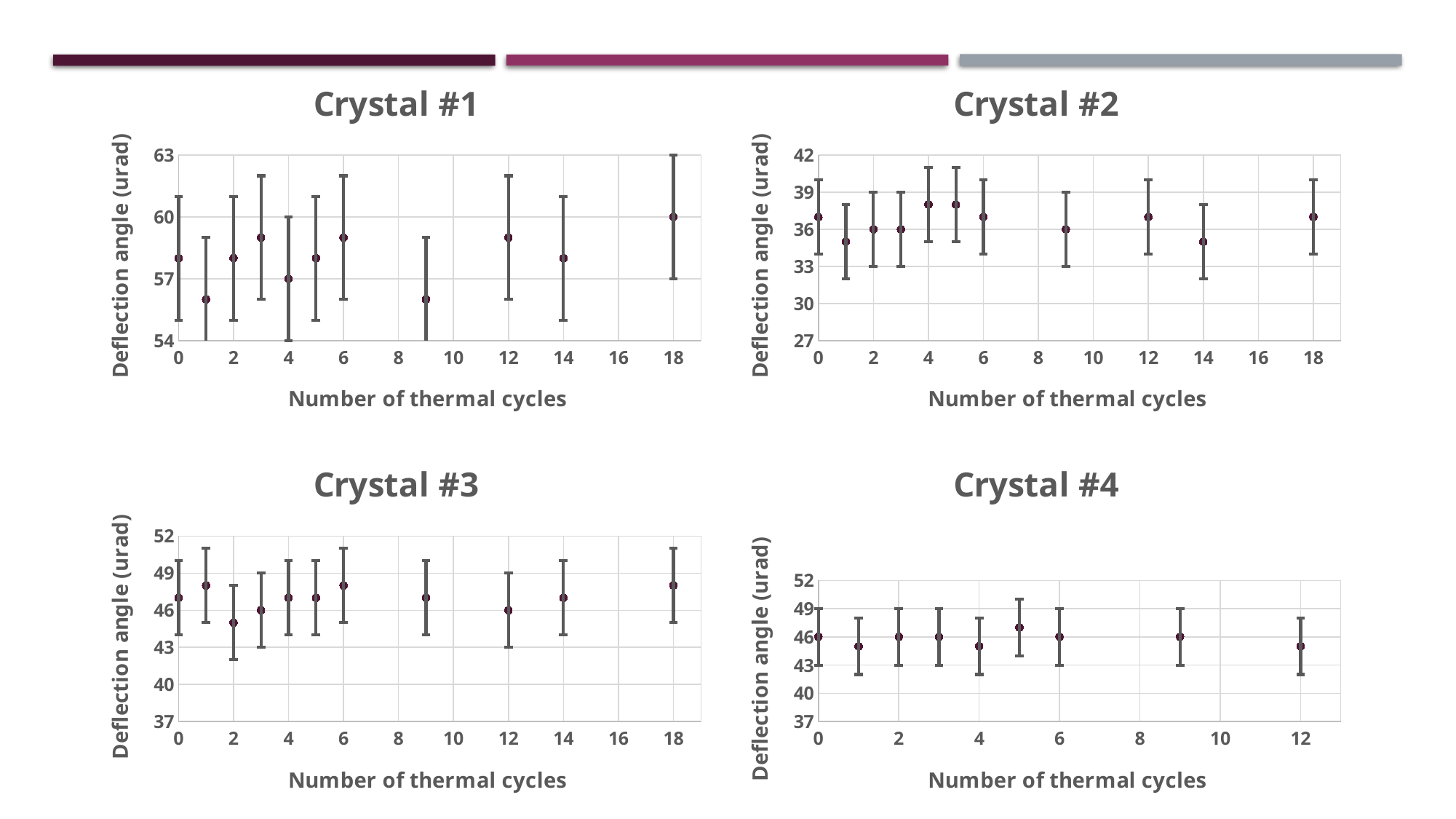
What kind of chart is the Crystal #3 chart? Scatter chart In the Crystal #2 chart, is the deflection angle at 4 thermal cycles greater or less than 36? greater In the Crystal #2 chart, what is the deflection angle at 9 thermal cycles? 36 In the Crystal #3 chart, is the deflection angle at 2 thermal cycles greater or less than 46? less In the Crystal #4 chart, at how many thermal cycles is the deflection angle highest? 5 In the Crystal #4 chart, what is the deflection angle at 0 thermal cycles? 46 In the Crystal #1 chart, what is the deflection angle at 4 thermal cycles? 57 In the Crystal #1 chart, is the deflection angle at 1 thermal cycle greater or less than 57? less What is the y-axis label of the Crystal #2 chart? Deflection angle (urad) In the Crystal #1 chart, at how many thermal cycles is the deflection angle highest? 18 How many data points are plotted in the Crystal #4 chart? 9 In the Crystal #1 chart, what is the deflection angle at 18 thermal cycles? 60